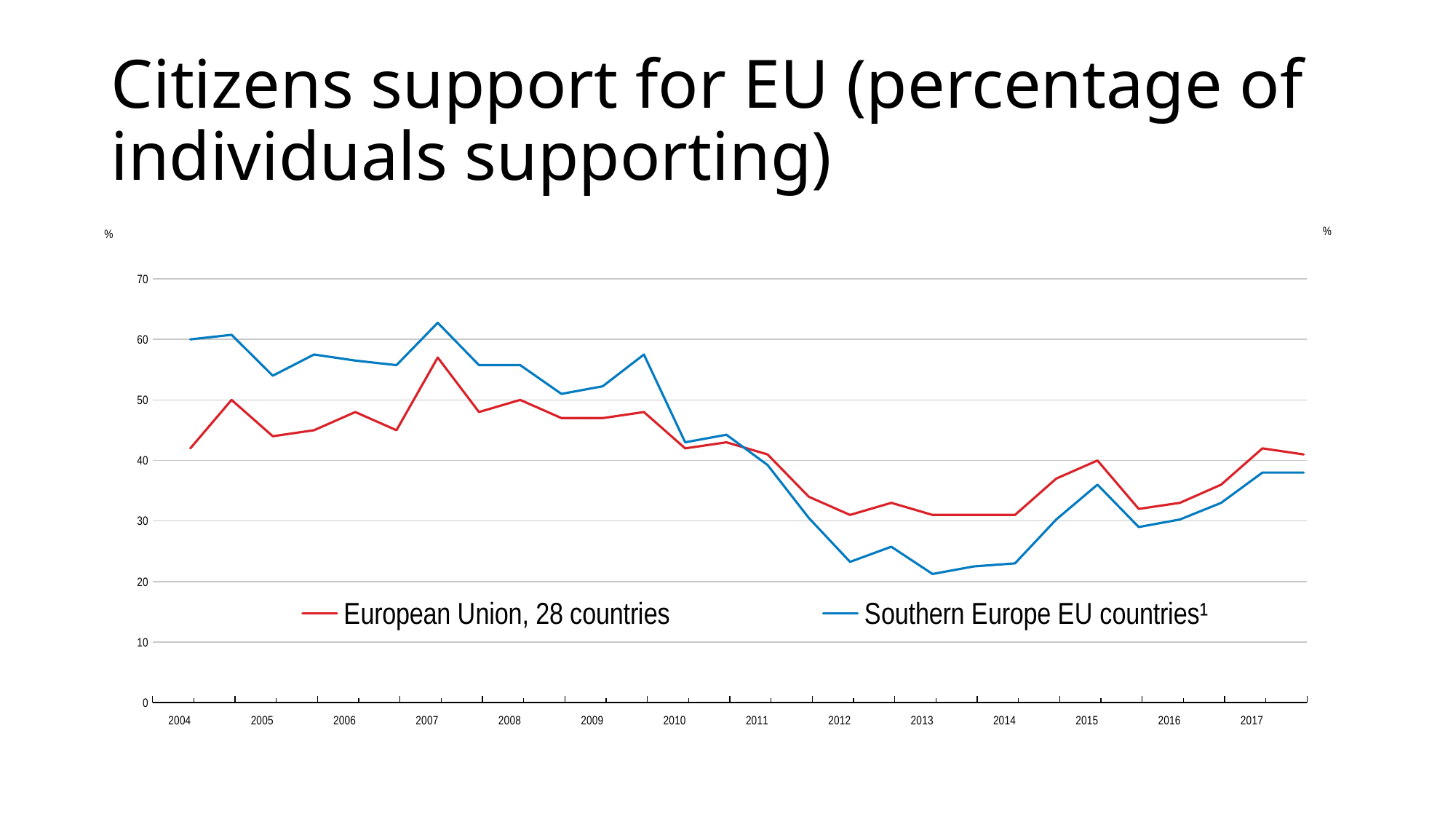
Which colour is used for the Southern Europe EU countries line? blue In 2004, which series has the higher value: European Union, 28 countries or Southern Europe EU countries? Southern Europe EU countries What kind of chart is shown on the slide? line chart What is the title of the chart on the slide? Citizens support for EU (percentage of individuals supporting) Is the value for Southern Europe EU countries at the end of 2017 greater or less than 40? less Is the value for European Union, 28 countries at the start of 2004 greater or less than 40? greater Does the Southern Europe EU countries line rise or fall between 2007 and 2013? fall Is the value for Southern Europe EU countries in 2013 greater or less than 30? less How many series does the legend list? 2 How many years are labelled on the x axis? 14 In 2013, which series has the higher value: European Union, 28 countries or Southern Europe EU countries? European Union, 28 countries